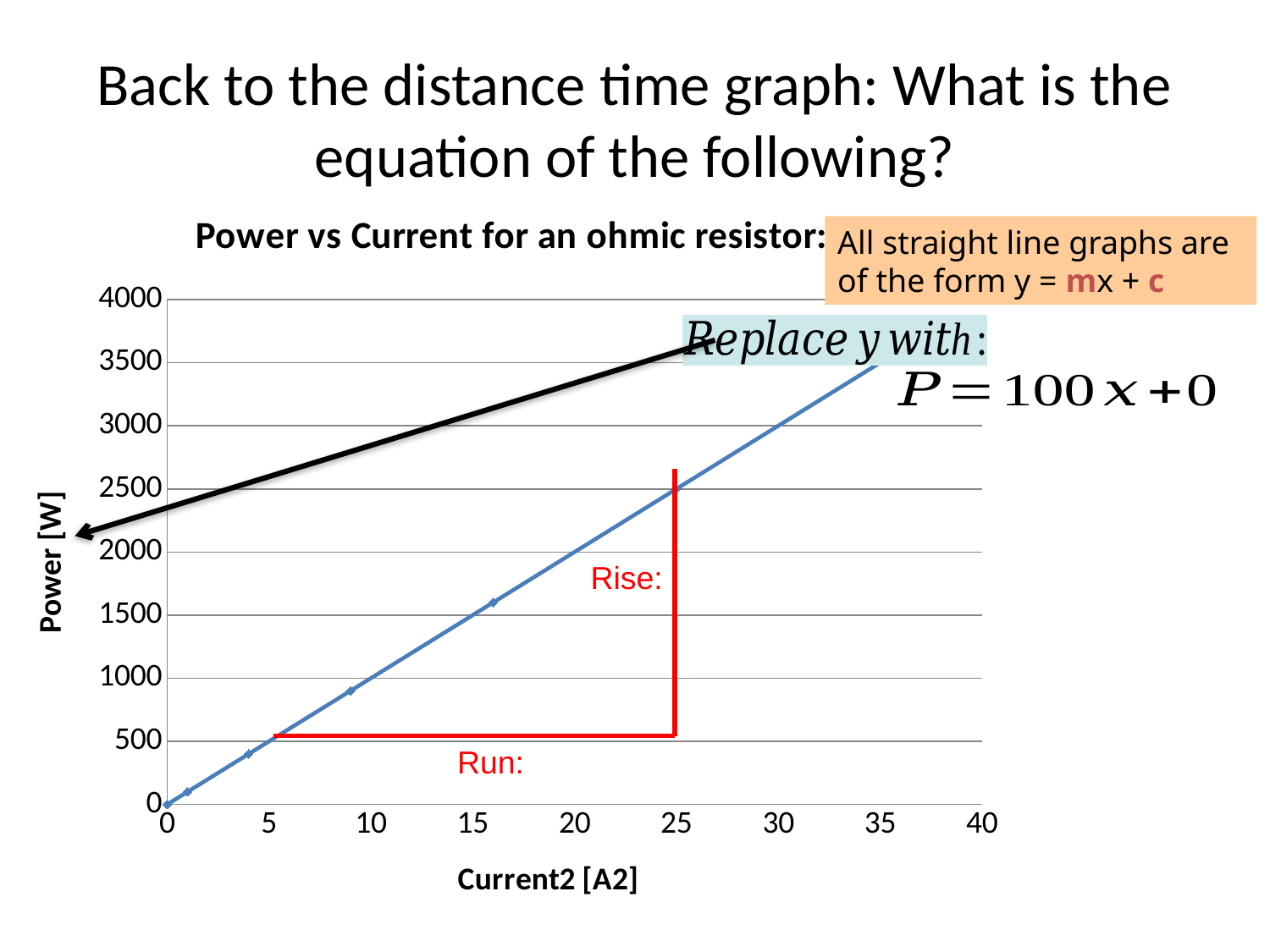
What is the power value of the data point at a current of 25 on the x axis? 2500 What is the highest value shown on the vertical axis of the chart? 4000 What is the power value of the data point at a current of 0 on the x axis? 0 Does the plotted power rise or fall as current increases along the x axis? rise Is the power value at a current of 16 greater or less than 1000? greater Is the power value at a current of 25 greater or less than 2000? greater Which data point has the lower power: the one at a current of 9 or the one at a current of 16? the one at a current of 9 What is the label of the vertical axis of the chart? Power [W] What kind of chart is shown on the slide? line chart Is the power value at a current of 4 greater or less than 500? less What is the title of the chart? Power vs Current for an ohmic resistor: